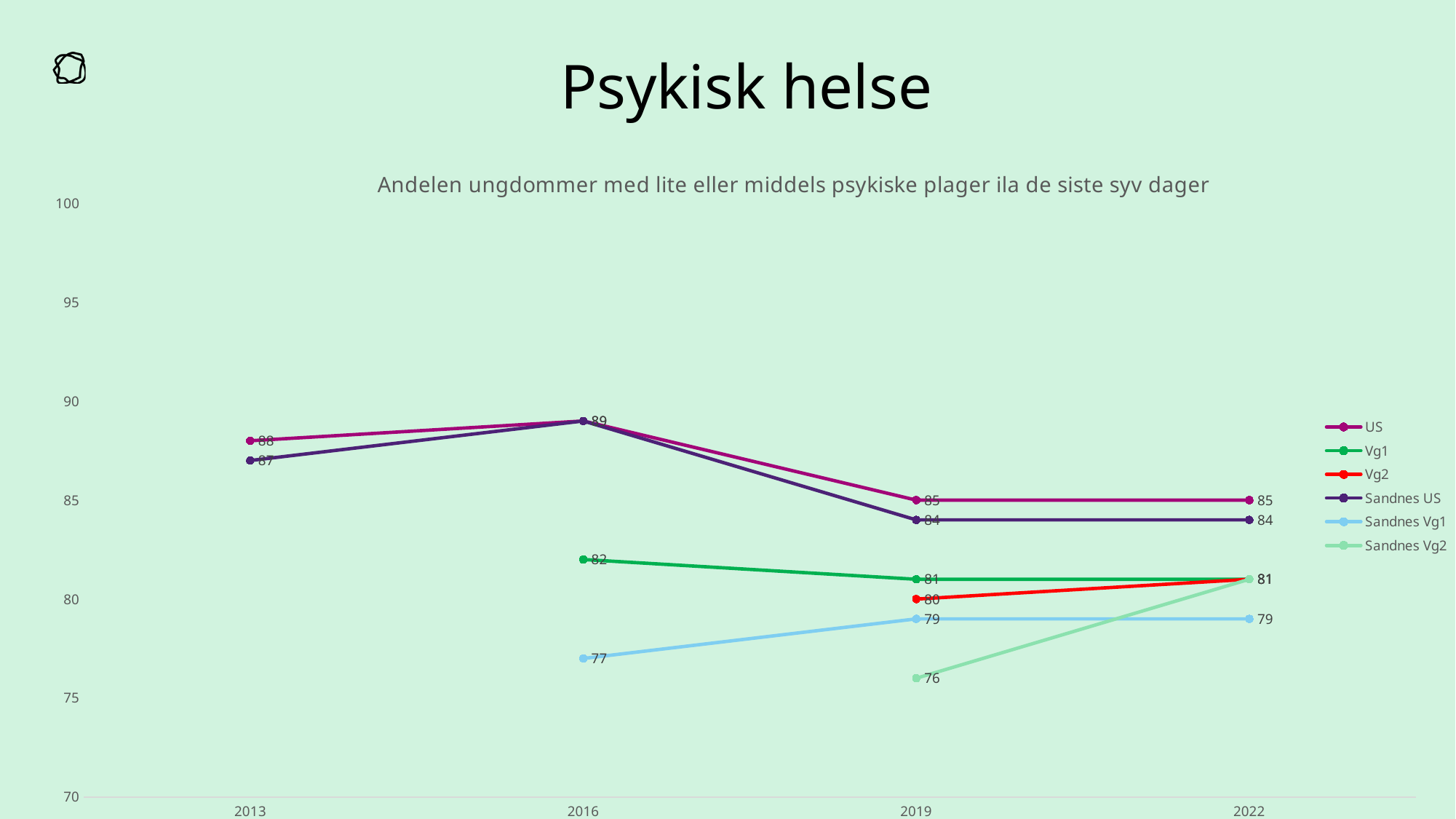
How many years are shown on the x axis? 4 What is the value for Sandnes Vg1 in 2016? 77 What is the value for Sandnes Vg2 in 2019? 76 How many series does the legend list? 6 Which is larger in 2013, US or Sandnes US? US What is the difference between the US value in 2016 and in 2019? 4 What is the value for Sandnes US in 2022? 84 In which year does Sandnes US reach its highest value? 2016 Which series has the lowest plotted value on the chart? Sandnes Vg2 What is the value for US in 2013? 88 What kind of chart is shown on the slide? line chart Does the Sandnes US line rise or fall from 2016 to 2019? fall